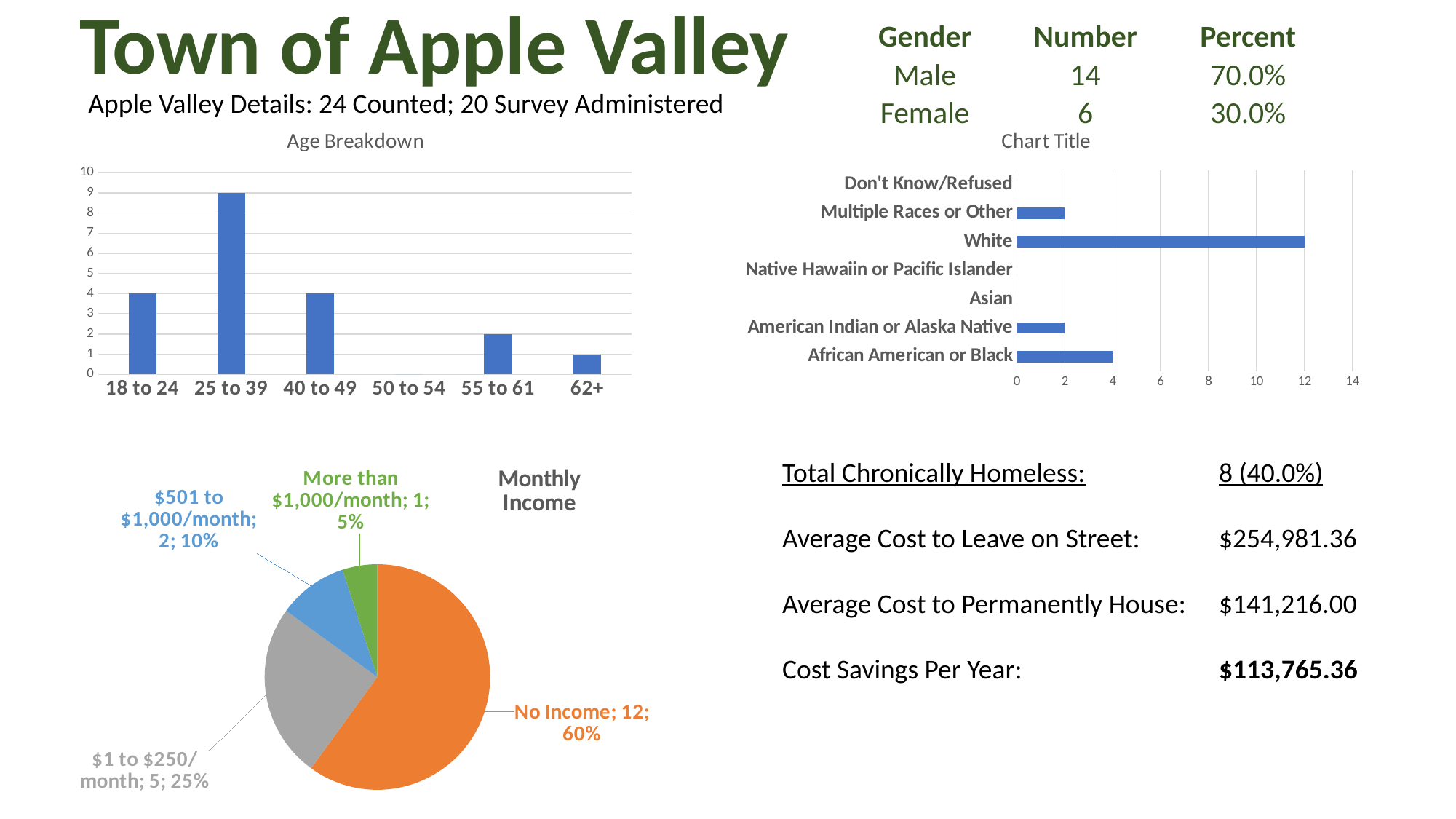
In the Monthly Income pie chart, how many people are in the $1 to $250/month category? 5 What kind of chart is the Age Breakdown chart? Bar chart In the chart titled 'Chart Title' on the right, what is the value for White? 12 In the Age Breakdown chart, which age group has the highest value? 25 to 39 In the chart titled 'Chart Title' on the right, is the value for White greater or less than 10? greater In the Age Breakdown chart, what is the value for the 25 to 39 age group? 9 In the Age Breakdown chart, what is the difference between the 25 to 39 and 55 to 61 age groups? 7 In the chart titled 'Chart Title' on the right, is the value for African American or Black larger or smaller than the value for Multiple Races or Other? Larger In the Monthly Income pie chart, which category has the smallest slice? More than $1,000/month In the chart titled 'Chart Title' on the right, which category has the highest value? White In the Age Breakdown chart, how many age categories are shown on the x axis? 6 In the Monthly Income pie chart, what share of the pie is No Income? 60%